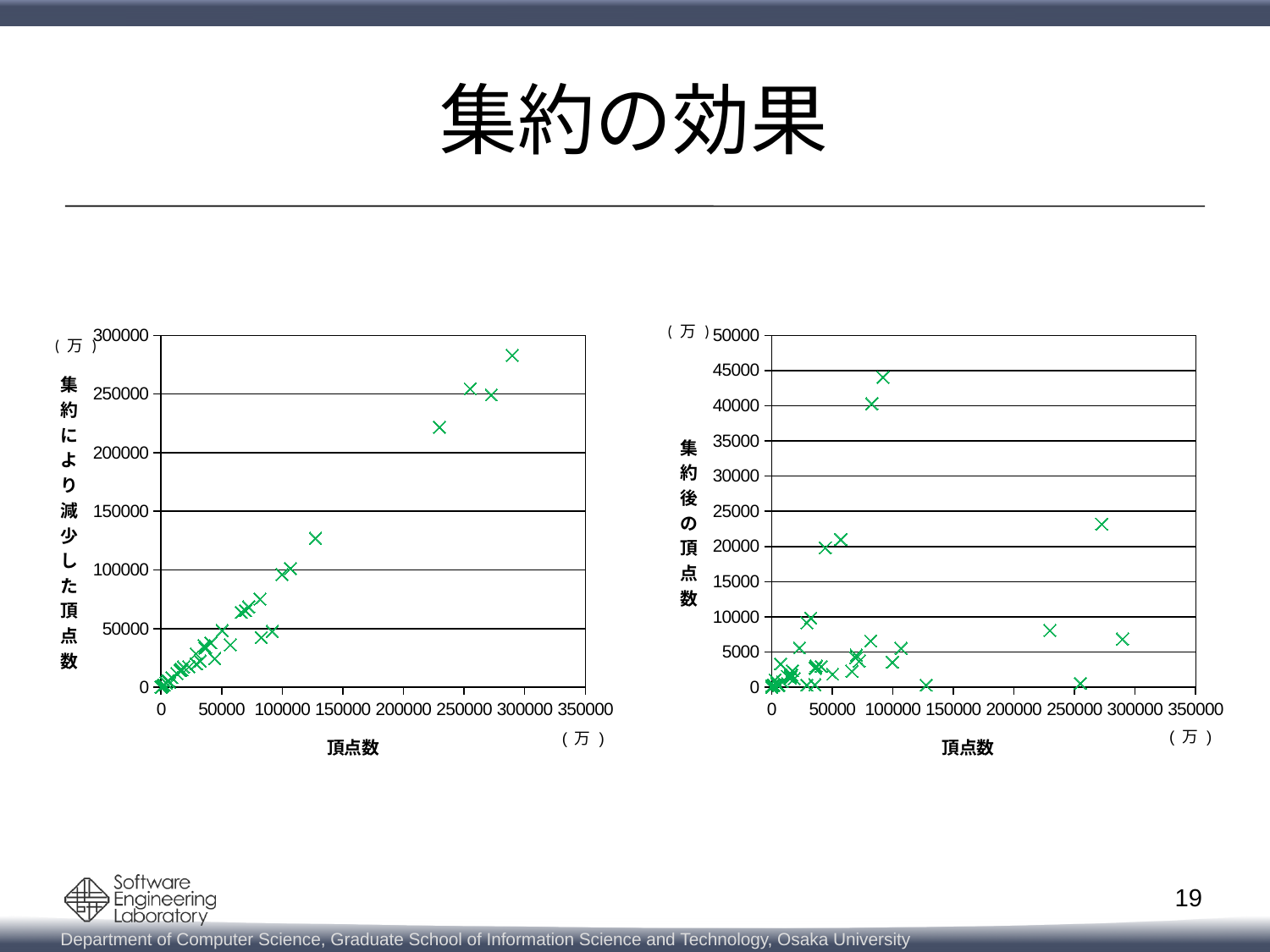
In the left chart, do the plotted values generally rise or fall as 頂点数 increases along the x axis? rise In the right chart, is the y value of the highest point greater or less than 40000? greater In the right chart, is the y value of the point near x = 275000 greater or less than 20000? greater What is the maximum value shown on the y axis of the left chart? 300000 What kind of chart is the right chart on the slide? scatter chart What is the maximum value shown on the y axis of the right chart? 50000 What is the x-axis title of the right chart? 頂点数 In the left chart, is the y value of the rightmost point greater or less than 250000? greater How many charts are shown on the slide? 2 What kind of chart is the left chart on the slide? scatter chart